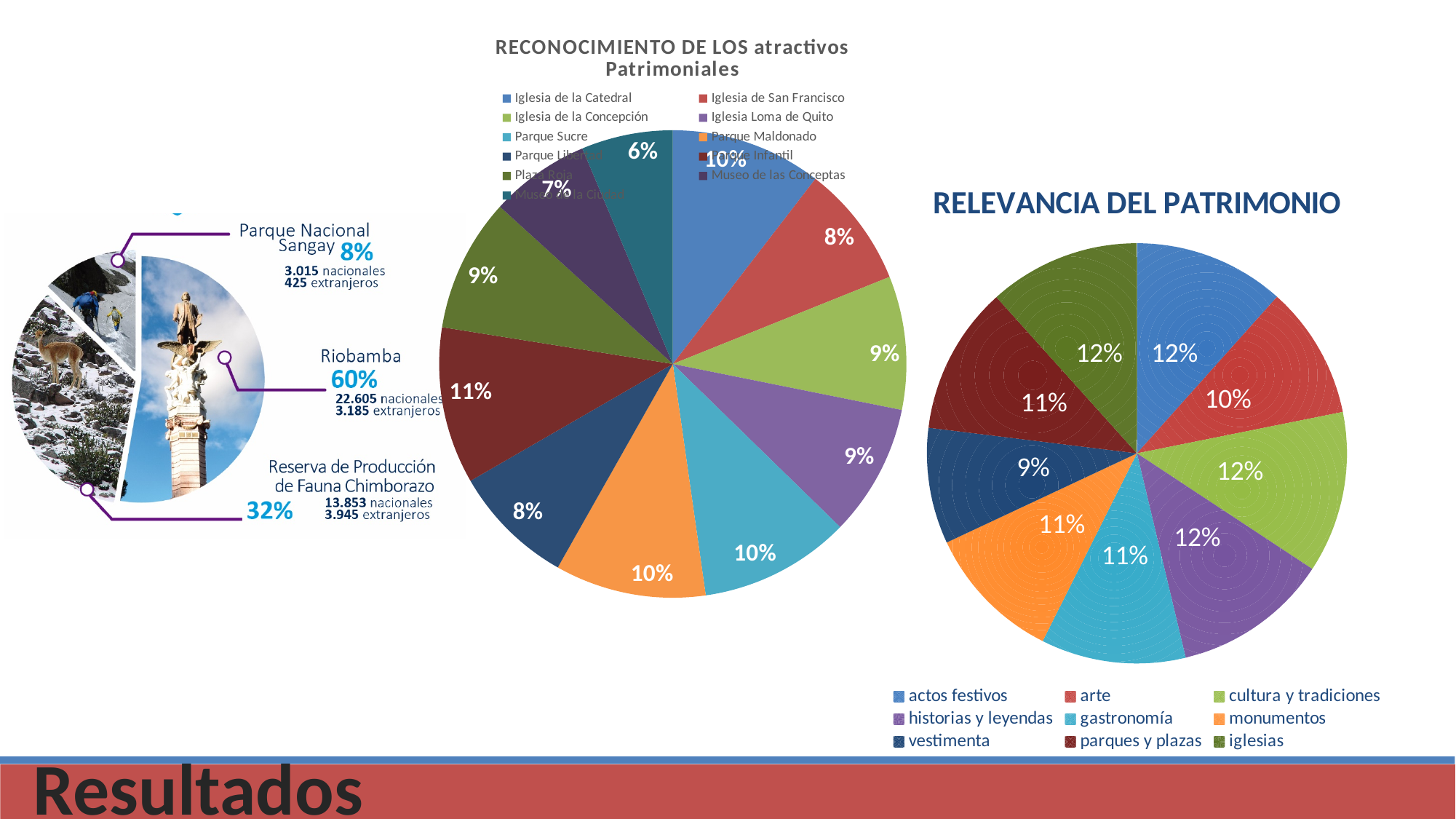
In the RELEVANCIA DEL PATRIMONIO chart, what is the difference between the shares for gastronomía and vestimenta? 2% In the RECONOCIMIENTO DE LOS atractivos Patrimoniales chart, what percentage is shown for Iglesia de San Francisco? 8% In the infographic pie chart on the left, what percentage is shown for Riobamba? 60% In the infographic pie chart on the left, what is the difference between the percentages for Reserva de Producción de Fauna Chimborazo and Parque Nacional Sangay? 24% In the RELEVANCIA DEL PATRIMONIO chart, how many categories does the legend list? 9 In the RELEVANCIA DEL PATRIMONIO chart, what percentage is shown for vestimenta? 9% In the RELEVANCIA DEL PATRIMONIO chart, what percentage is shown for arte? 10% In the RECONOCIMIENTO DE LOS atractivos Patrimoniales chart, what percentage is shown for Parque Sucre? 10% In the RELEVANCIA DEL PATRIMONIO chart, which category has the smallest share? vestimenta In the RELEVANCIA DEL PATRIMONIO chart, which is larger, the share for monumentos or the share for arte? monumentos In the RECONOCIMIENTO DE LOS atractivos Patrimoniales chart, what is the smallest percentage shown on any slice? 6% What type of chart is RECONOCIMIENTO DE LOS atractivos Patrimoniales? pie chart